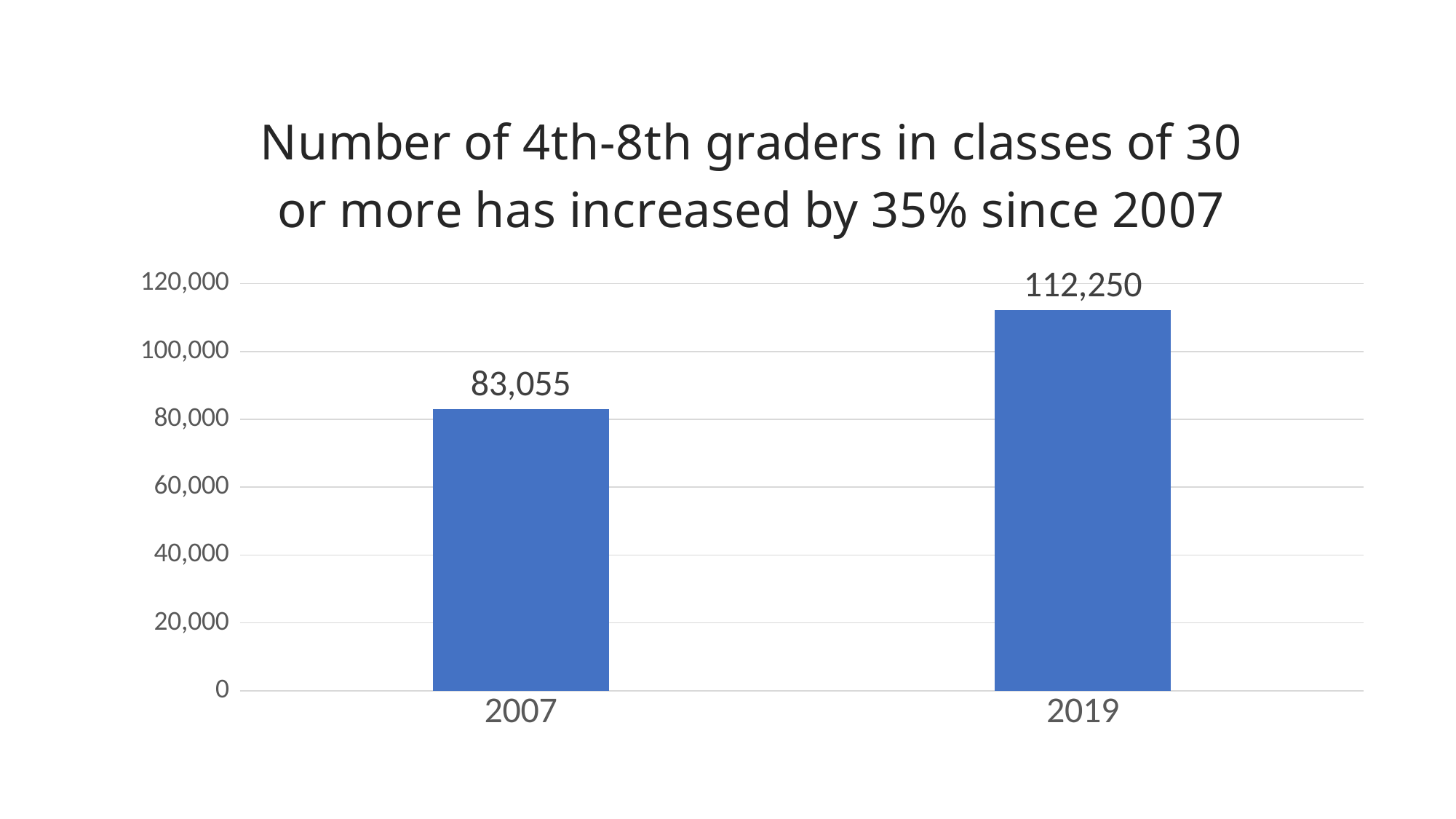
Which year has the lower value? 2007 What kind of chart is shown on the slide? Bar chart What is the value for 2007? 83,055 What is the value for 2019? 112,250 Is the value for 2019 greater or less than 100,000? greater How many bars are shown in the chart? 2 Do the values rise or fall from 2007 to 2019? Rise Is the value for 2019 larger than the value for 2007? Yes Is the value for 2007 greater or less than 100,000? less What is the difference between the 2019 value and the 2007 value? 29,195 Which year has the higher value? 2019 By what percentage does the chart title say the number has increased since 2007? 35%